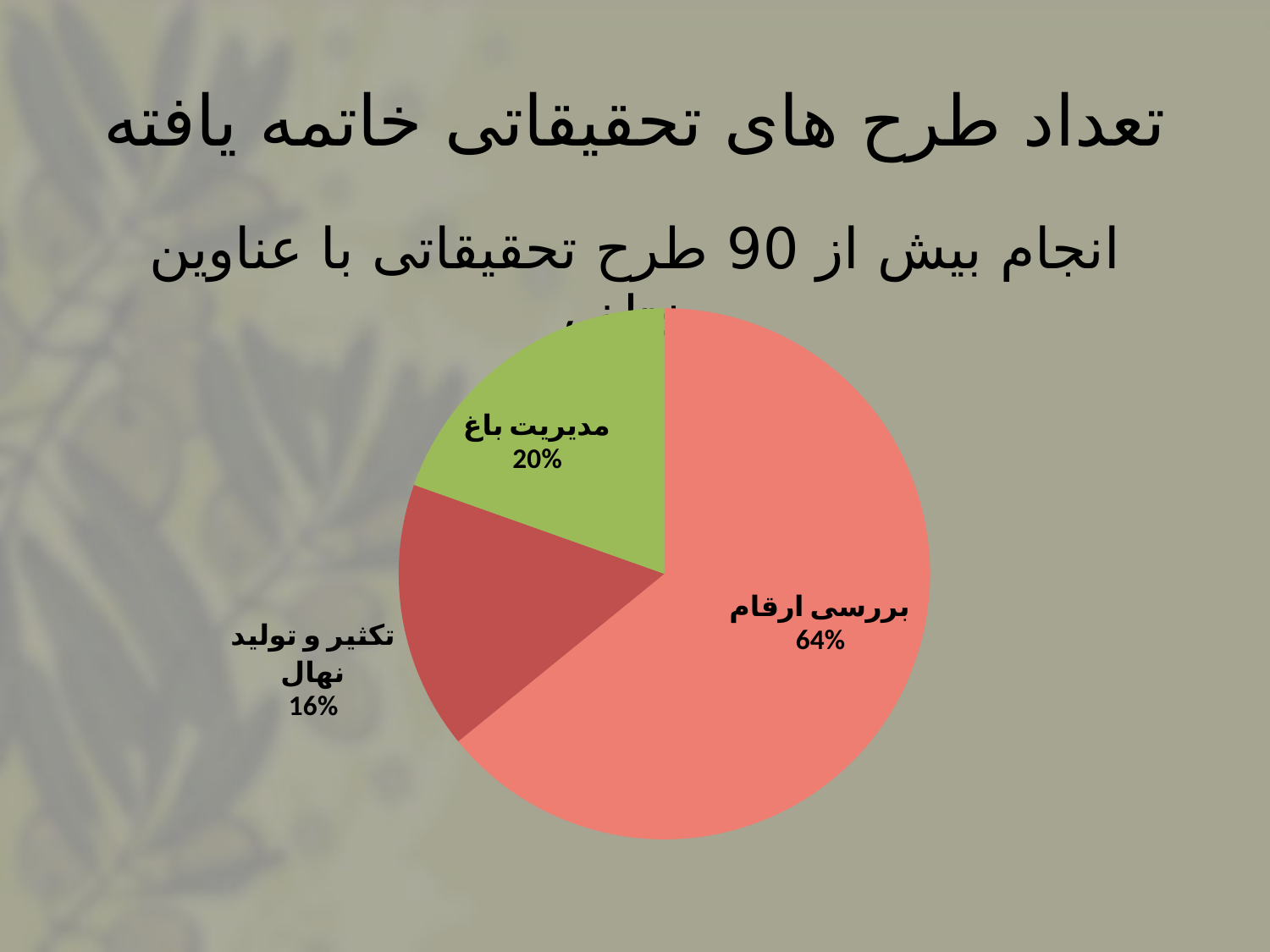
Which slice of the pie chart is the largest? بررسی ارقام What share of the pie does مدیریت باغ have? 20% What kind of chart is shown on the slide? pie chart What is the difference in percentage points between the مدیریت باغ slice and the تکثیر و تولید نهال slice? 4 Which is larger, the share for مدیریت باغ or the share for تکثیر و تولید نهال? مدیریت باغ What share of the pie does بررسی ارقام have? 64% Which slice of the pie chart is the smallest? تکثیر و تولید نهال What is the title of the slide containing the pie chart? تعداد طرح های تحقیقاتی خاتمه یافته What share of the pie does تکثیر و تولید نهال have? 16% How many slices does the pie chart have? 3 What is the difference in percentage points between the بررسی ارقام slice and the مدیریت باغ slice? 44 What colour is the مدیریت باغ slice of the pie chart? green